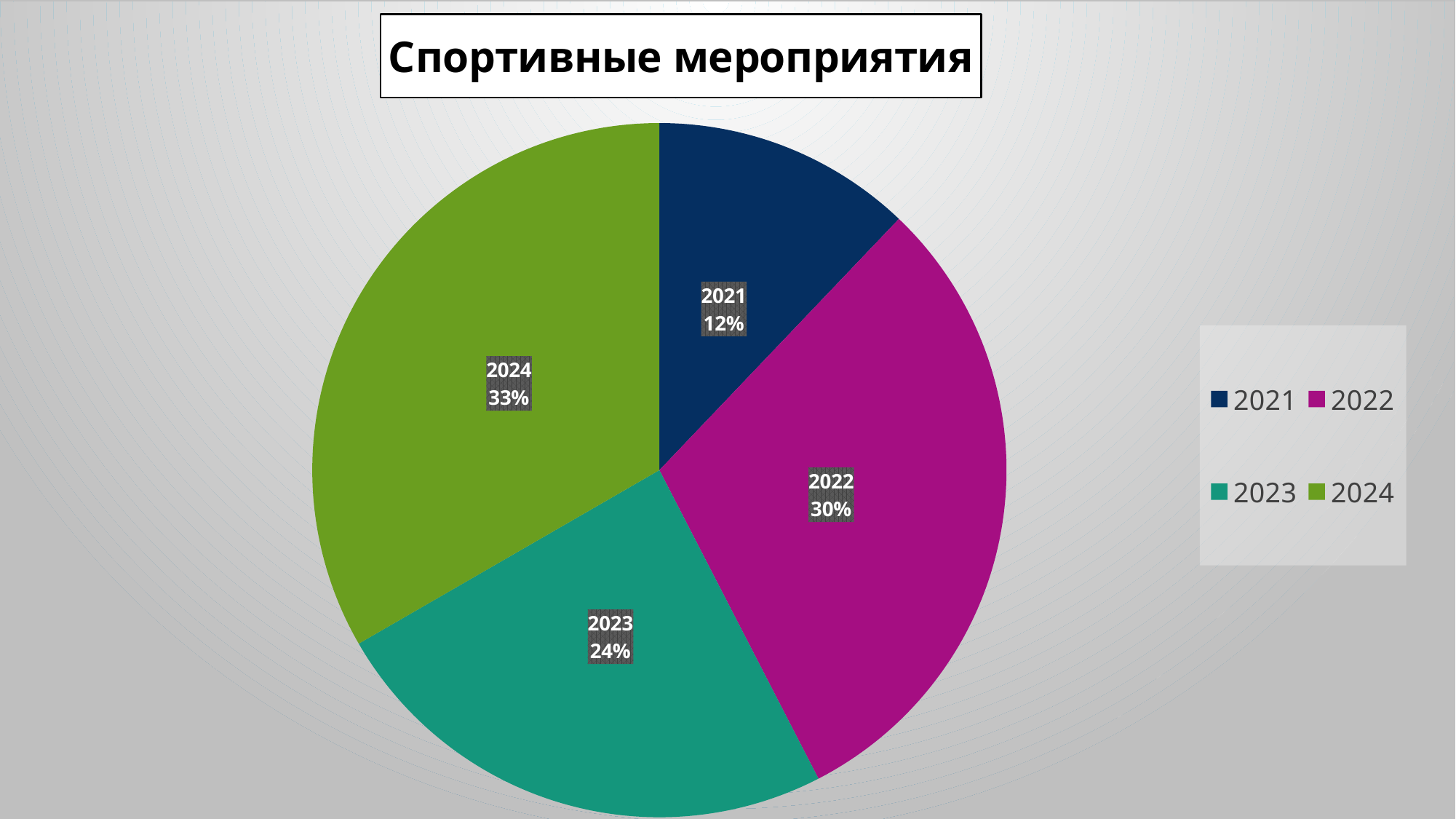
What share of the pie does 2024 have? 33% How many slices does the pie chart have? 4 What is the difference in percentage points between the 2022 and 2023 slices? 6 Which slice is larger, 2022 or 2023? 2022 What is the difference in percentage points between the 2024 and 2021 slices? 21 What share of the pie does 2023 have? 24% Which year has the smallest slice of the pie? 2021 What share of the pie does 2022 have? 30% Which year has the largest slice of the pie? 2024 What kind of chart is shown on the slide? pie chart What is the title of the chart? Спортивные мероприятия